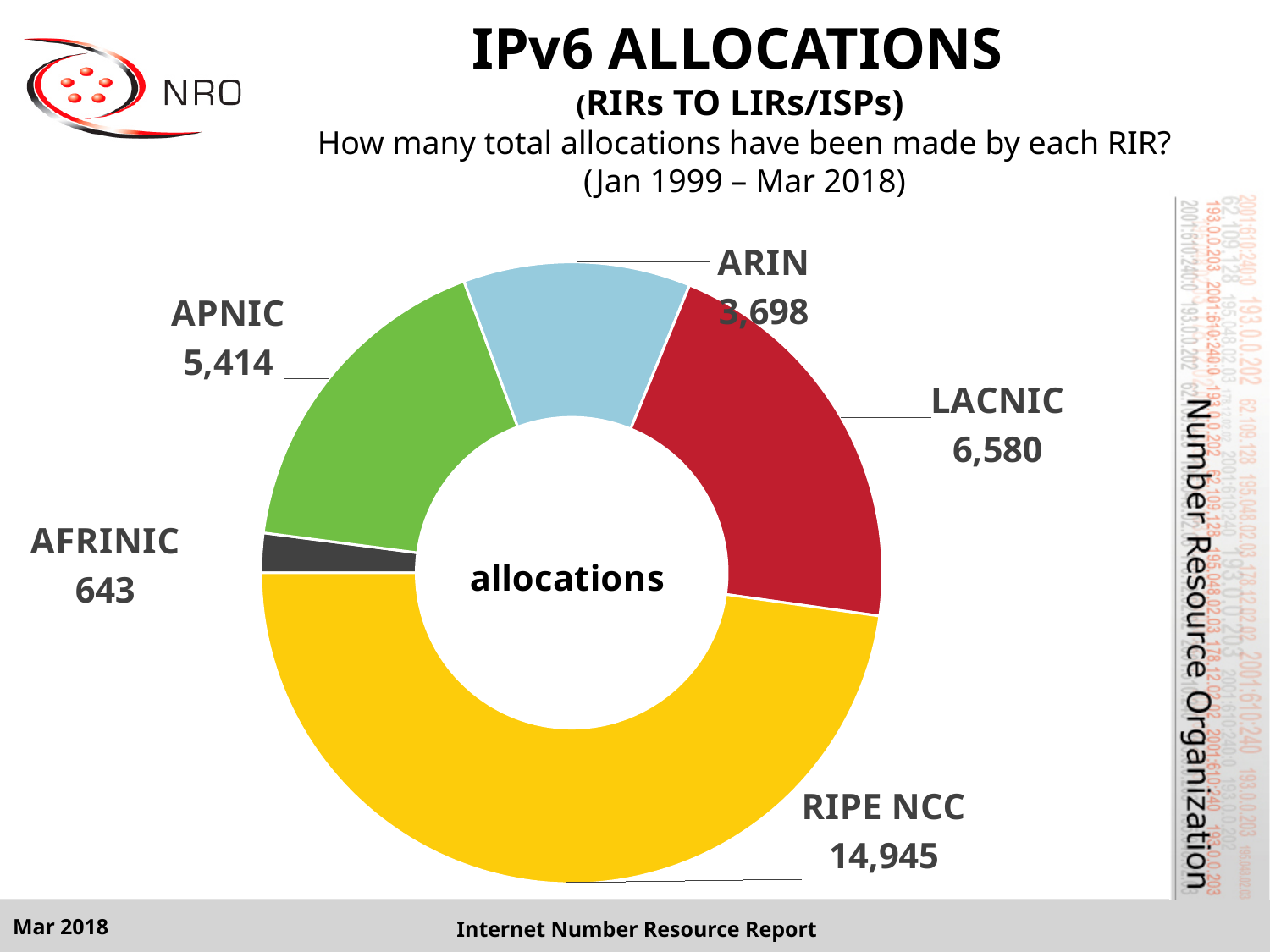
What is the total number of allocations across all five RIRs shown? 31,280 What is the value shown for LACNIC? 6,580 How many RIRs are shown as slices in the chart? 5 What is the value shown for AFRINIC? 643 What is the difference between the RIPE NCC and LACNIC allocations? 8,365 Which has more IPv6 allocations, LACNIC or APNIC? LACNIC What is the difference between the APNIC and ARIN allocations? 1,716 What is the value shown for APNIC? 5,414 What type of chart is shown on the slide? Pie chart (donut) How many IPv6 allocations has RIPE NCC made according to the chart? 14,945 Which RIR has the smallest number of IPv6 allocations? AFRINIC Which RIR has the largest number of IPv6 allocations? RIPE NCC